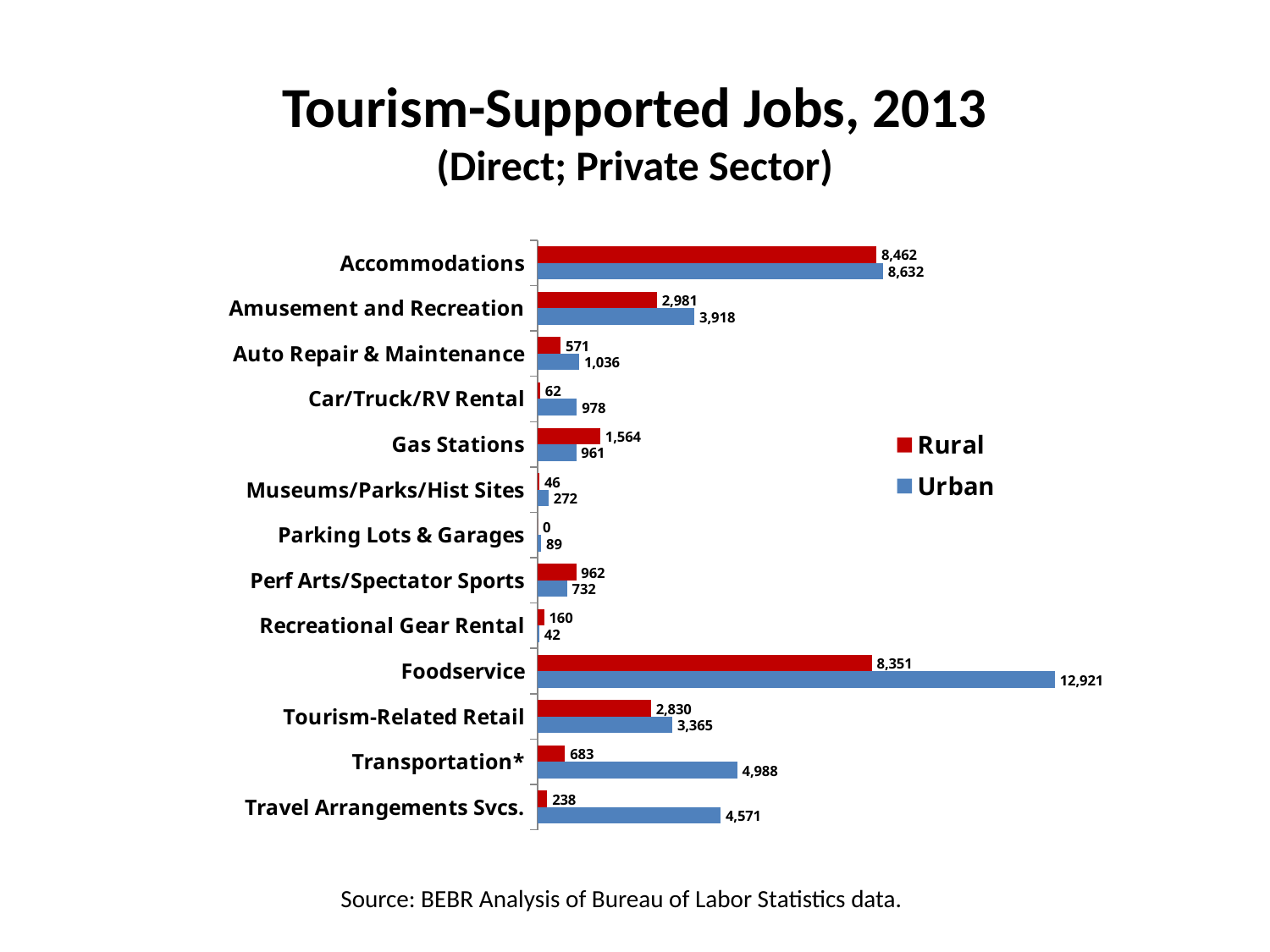
What kind of chart is shown on the slide? Bar chart What is the Rural value for Gas Stations? 1,564 Which is larger for Travel Arrangements Svcs., the Rural value or the Urban value? Urban How many categories are shown on the chart? 13 What is the Rural value for Parking Lots & Garages? 0 What colour represents the Urban series? Blue Which category has the highest Urban value? Foodservice What is the difference between the Urban and Rural values for Transportation*? 4,305 Which is larger for Gas Stations, the Rural value or the Urban value? Rural How many series does the legend list? 2 What is the Urban value for Foodservice? 12,921 Which category has the lowest Rural value? Parking Lots & Garages